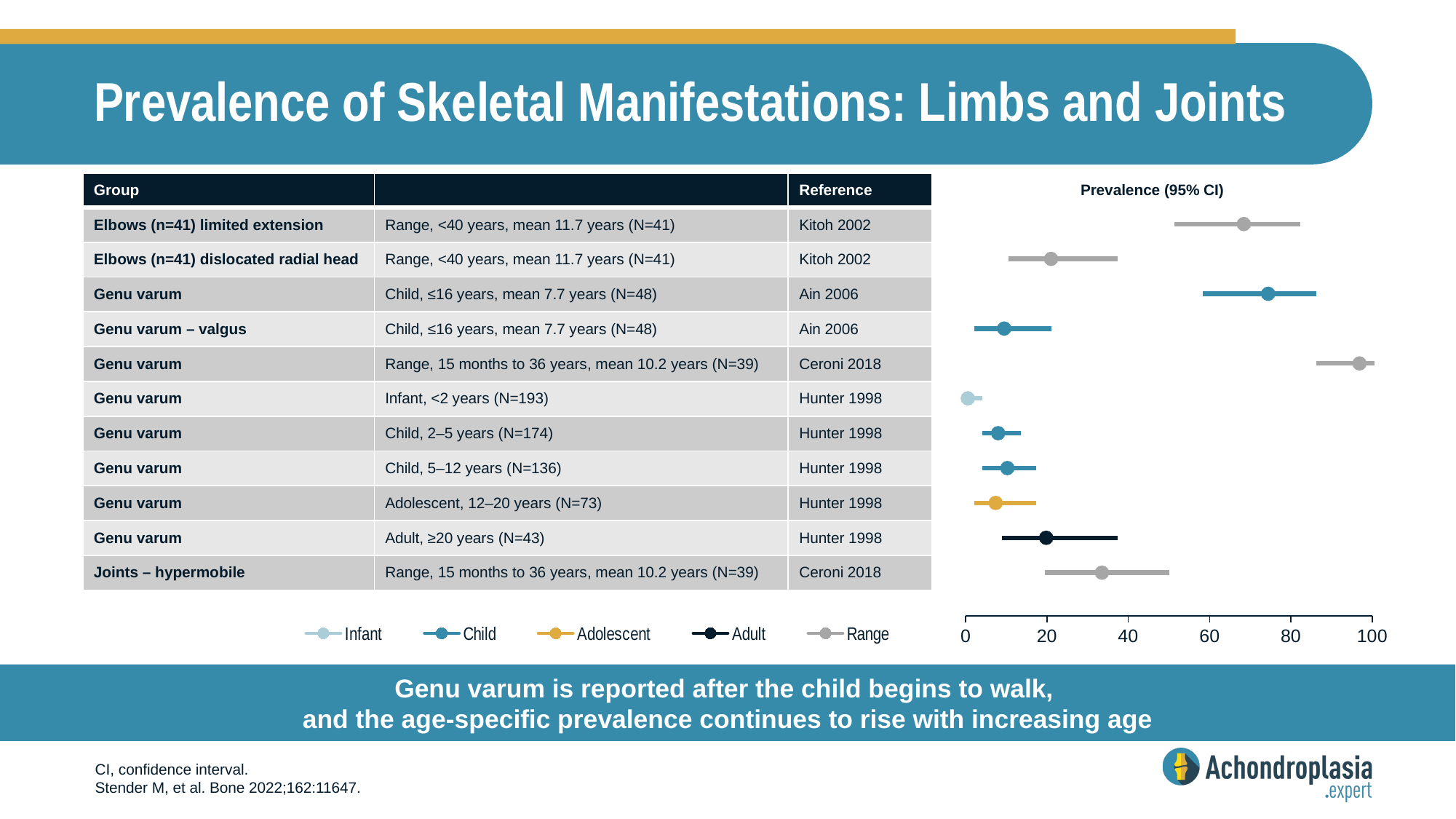
Which group has the highest prevalence point estimate? Genu varum, Ceroni 2018 (Range, 15 months to 36 years) Which has the higher prevalence point estimate: Genu varum (Ain 2006) or Genu varum – valgus (Ain 2006)? Genu varum (Ain 2006) How many series does the chart legend list? 5 Is the prevalence point estimate for Genu varum in Ain 2006 (Child, ≤16 years) greater or less than 60? greater Is the prevalence point estimate for Joints – hypermobile greater or less than 40? less Is the prevalence point estimate for Elbows (n=41) dislocated radial head greater or less than 40? less What is the title shown above the chart? Prevalence (95% CI) Which has the higher prevalence point estimate: Elbows limited extension or Elbows dislocated radial head? Elbows limited extension What kind of chart is shown on the right of the slide? Forest plot (dot plot with confidence intervals) Which group has the lowest prevalence point estimate? Genu varum, Infant, <2 years (Hunter 1998) How many groups (rows) are plotted in the prevalence chart? 11